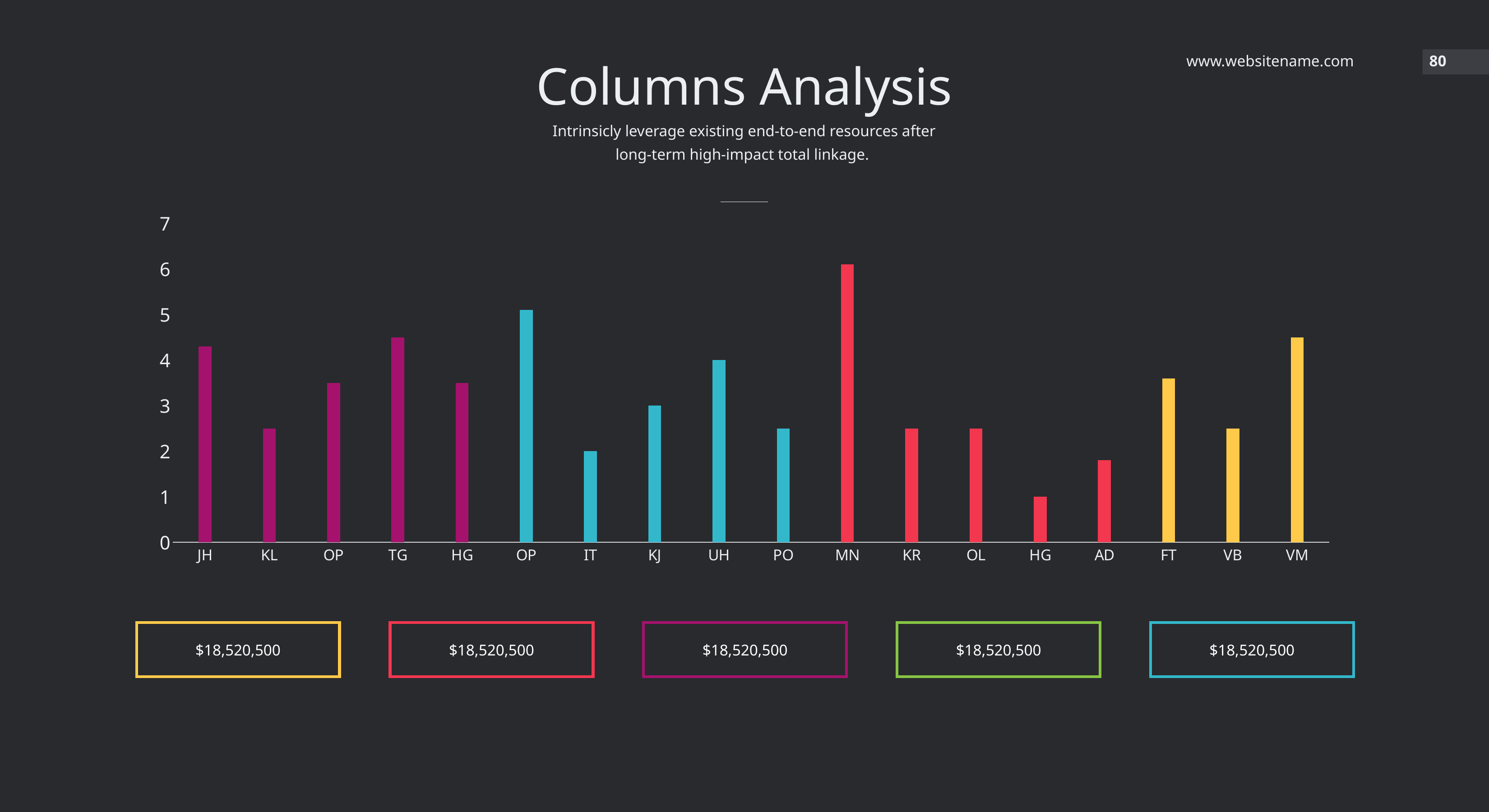
How many bars (categories) are plotted in the chart? 18 Is the value for IT greater or less than 3? less Which category has the lowest bar in the chart? HG (the one between OL and AD) What colour is the bar for MN? red Is the value for MN greater or less than 5? greater Which is larger, the value for JH or the value for KL? JH Is the value for VM greater or less than 4? greater Which is larger, the value for MN or the value for VM? MN What kind of chart is shown on the slide? bar chart Which category has the highest bar in the chart? MN What is the title of the chart on the slide? Columns Analysis